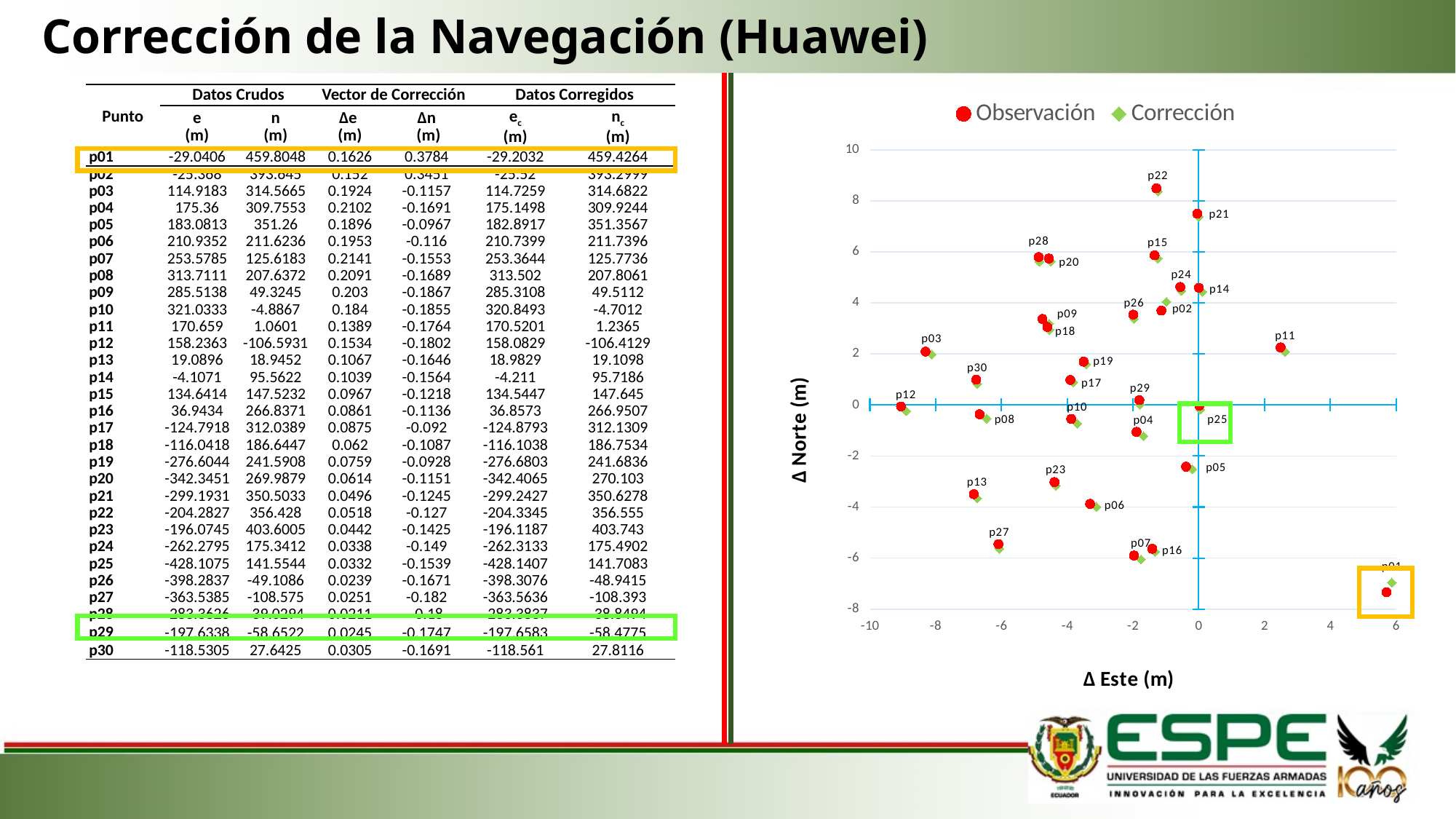
Which point has a larger Δ Este value, p11 or p12? p11 How many series does the chart legend list? 2 What kind of chart is shown on the slide? Scatter chart Is the Δ Norte value for p22 greater or less than 8? greater Which labeled point has the lowest Δ Este value in the chart? p12 Which labeled point has the lowest Δ Norte value in the chart? p01 What are the two series named in the chart legend? Observación and Corrección Is the Δ Norte value for p27 greater or less than -4? less Is the Δ Este value for p11 greater or less than 2? greater What are the titles of the horizontal and vertical axes of the chart? Δ Este (m) and Δ Norte (m) Which point has a higher Δ Norte value, p22 or p21? p22 Which labeled point has the highest Δ Norte value in the chart? p22